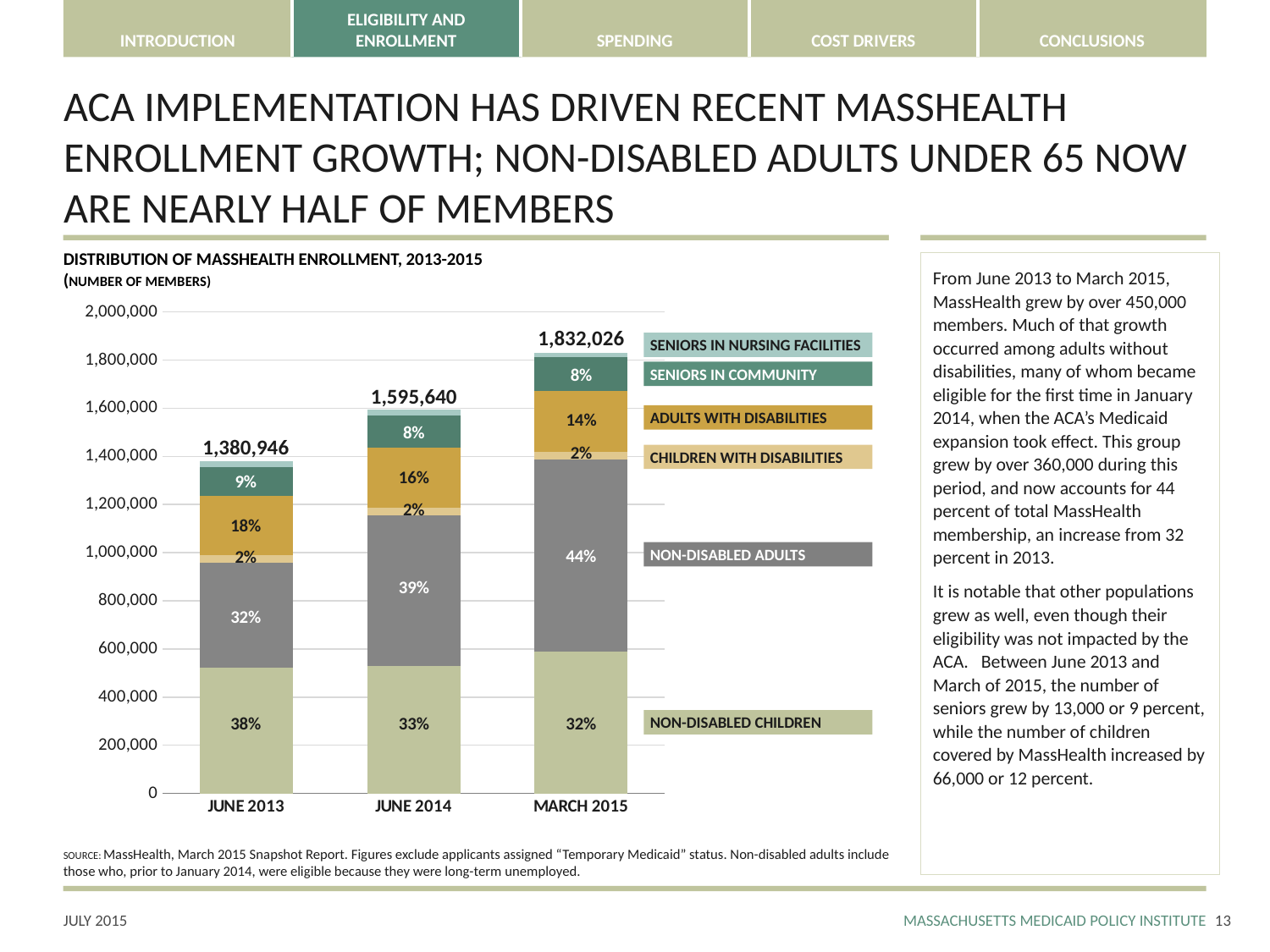
What percentage of members in June 2014 were non-disabled adults? 39% How many time periods are shown on the x axis? 3 What percentage of members in March 2015 were adults with disabilities? 14% Is the total enrollment for June 2014 greater or less than 1,400,000? greater Does total enrollment rise or fall from June 2013 to March 2015? rise Which period has the lowest total enrollment? June 2013 How many enrollment categories does the legend list? 6 What percentage of members in June 2013 were non-disabled children? 38% Which period has the highest total enrollment? March 2015 By how many members did total enrollment grow from June 2013 to March 2015? 451,080 What is the total number of members shown for March 2015? 1,832,026 What is the total number of members shown for June 2013? 1,380,946